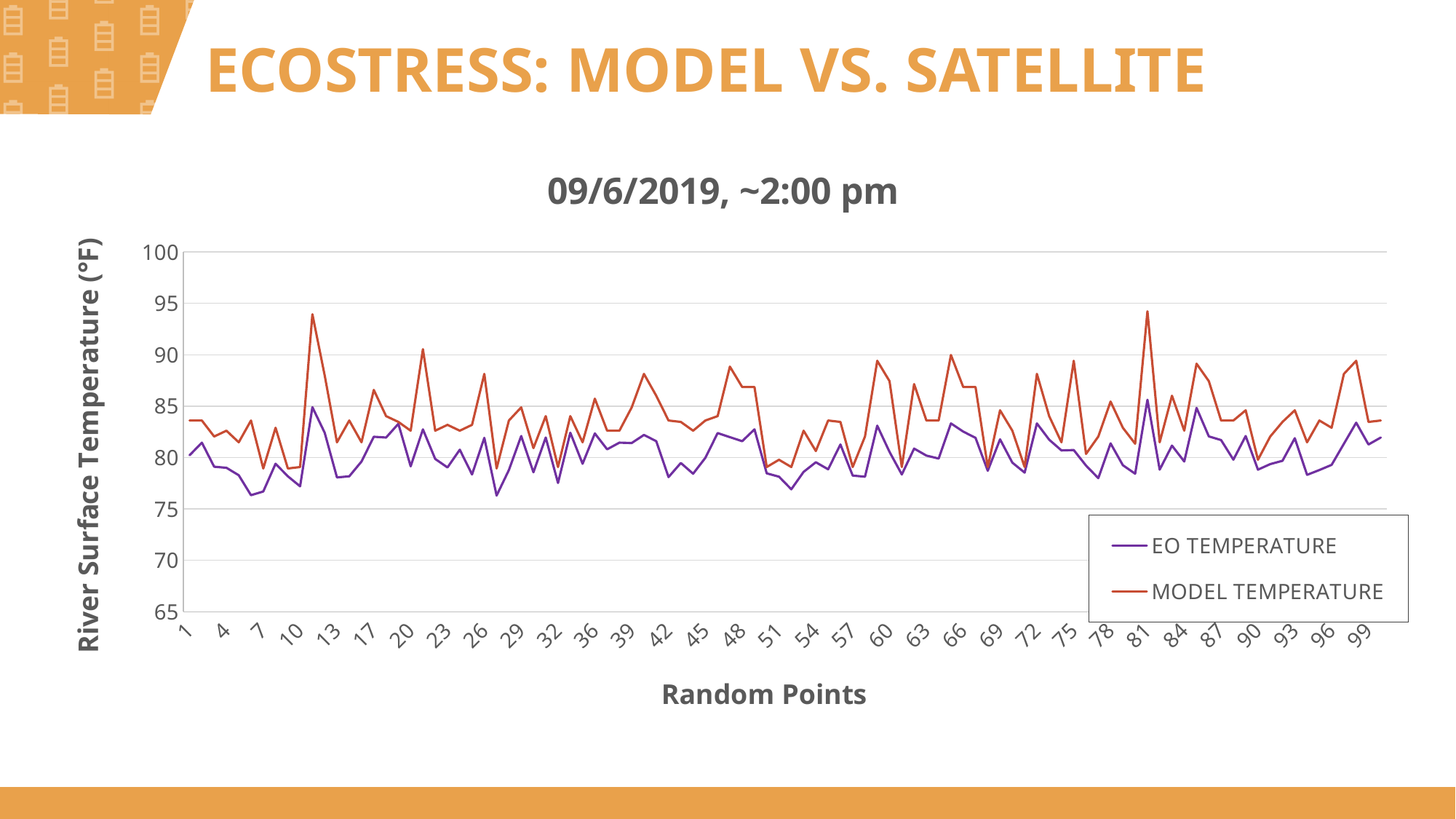
Is the MODEL TEMPERATURE value at point 11 greater or less than 90? greater Is the EO TEMPERATURE value at point 7 greater or less than 80? less At point 11, which series has the larger value, EO TEMPERATURE or MODEL TEMPERATURE? MODEL TEMPERATURE Which series reaches the highest value anywhere on the chart? MODEL TEMPERATURE What kind of chart is shown on the slide? line chart At point 81, which series has the larger value, EO TEMPERATURE or MODEL TEMPERATURE? MODEL TEMPERATURE How many series does the legend list? 2 Is the EO TEMPERATURE value at point 1 greater or less than 85? less What is the title of the chart? 09/6/2019, ~2:00 pm What is the label of the y axis? River Surface Temperature (°F)